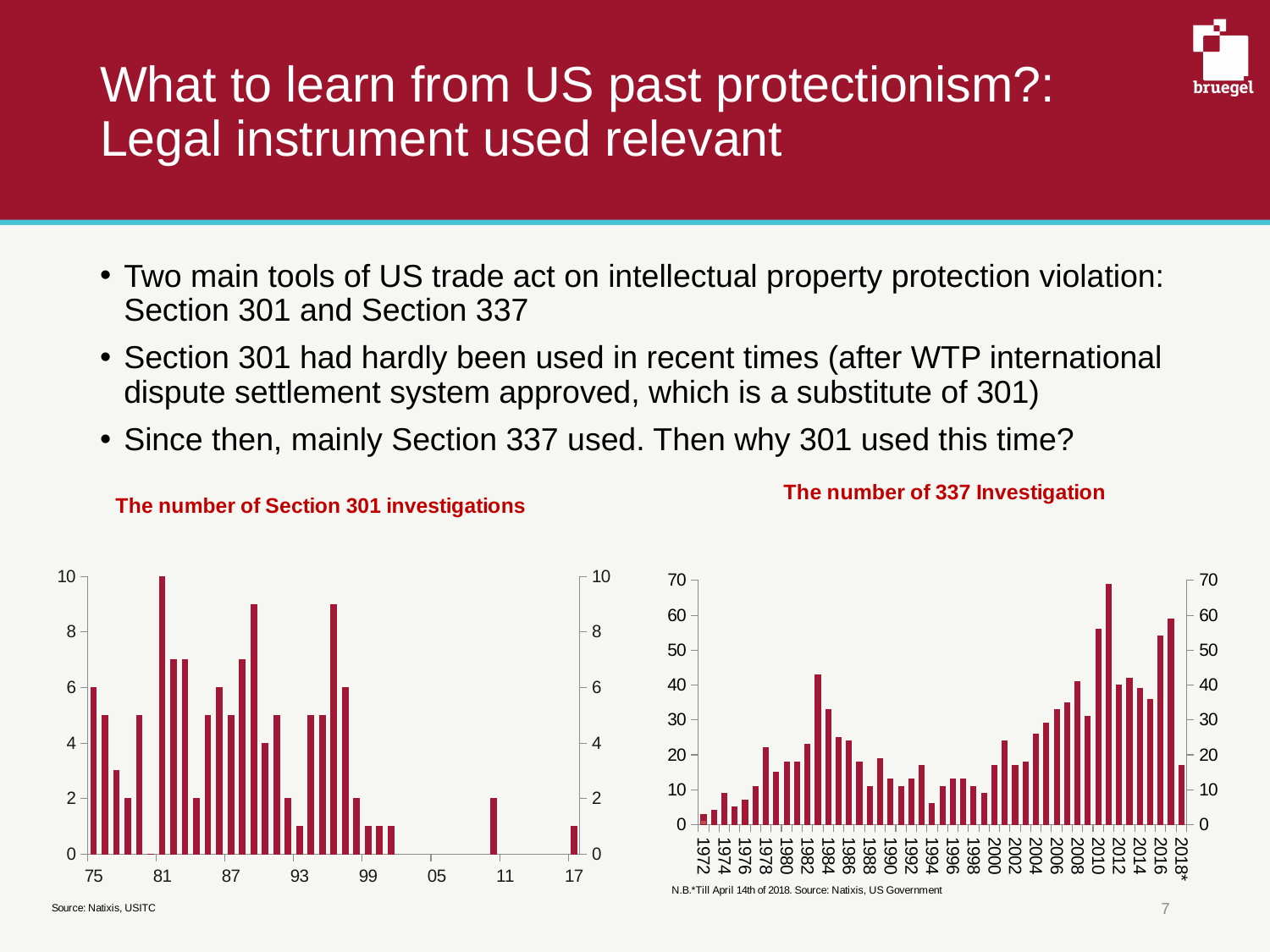
In 'The number of 337 Investigation' chart, is the value for 1994 greater or less than 10? less In 'The number of 337 Investigation' chart, which year has the highest bar? 2011 In 'The number of Section 301 investigations' chart, which is larger, the value for 75 or the value for 81? 81 In 'The number of 337 Investigation' chart, which is larger, the value for 1984 or the value for 2011? 2011 In 'The number of Section 301 investigations' chart, is the value for 17 greater or less than 2? less In 'The number of Section 301 investigations' chart, is the value for 81 greater or less than 8? greater How many charts are shown on the slide? 2 What kind of chart is 'The number of 337 Investigation'? bar chart In 'The number of Section 301 investigations' chart, which year has the highest bar? 81 In 'The number of 337 Investigation' chart, do the values generally rise or fall from 2000 to 2011? rise What kind of chart is 'The number of Section 301 investigations'? bar chart